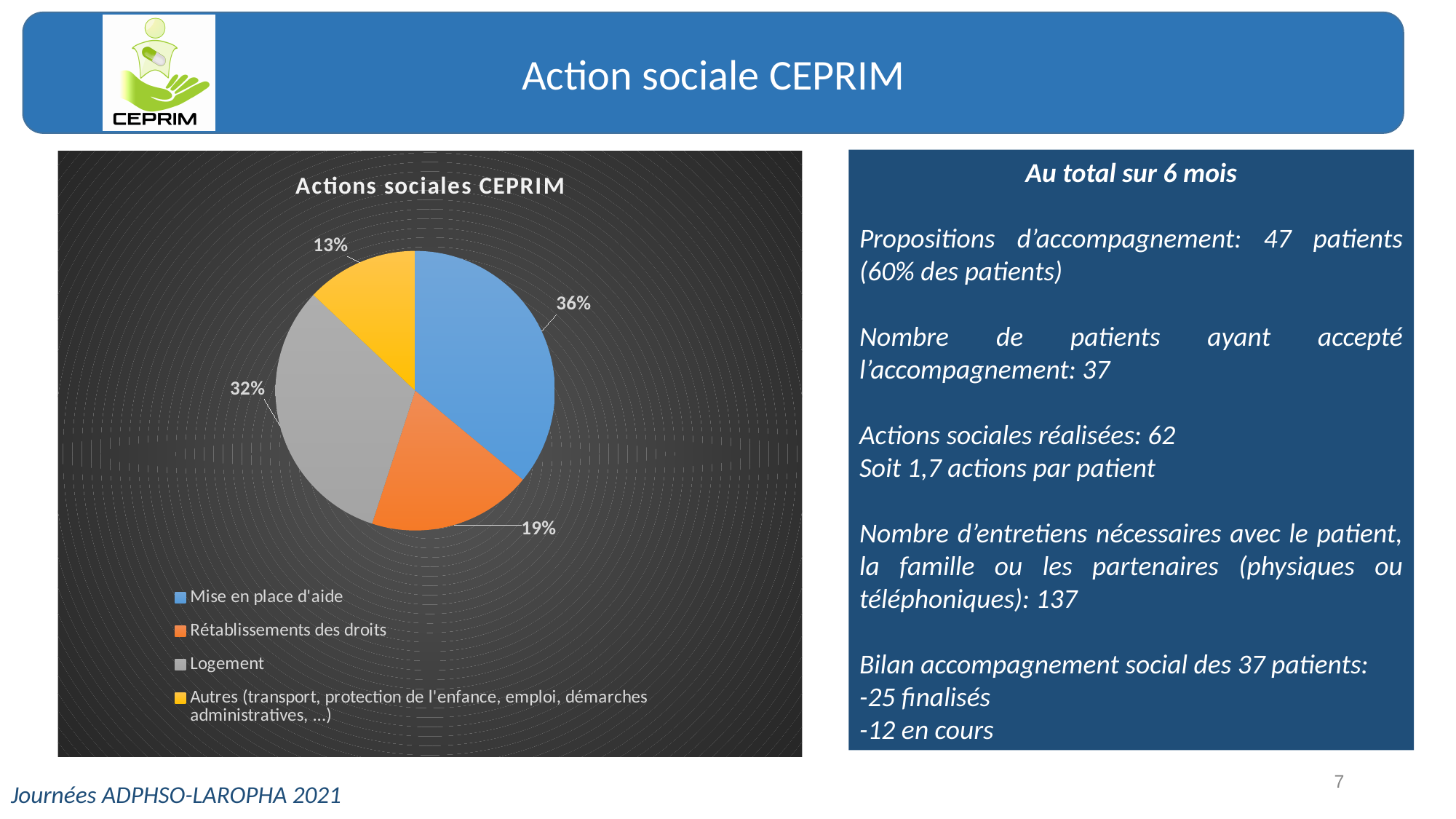
Which colour represents "Logement" in the pie chart? gray What type of chart is shown on the slide? pie chart Which category has the smallest share of the pie? Autres (transport, protection de l'enfance, emploi, démarches administratives, ...) Which category has the largest share of the pie? Mise en place d'aide What share of the pie does the "Autres" category represent? 13% What share of the pie does "Mise en place d'aide" represent? 36% What is the title of the chart? Actions sociales CEPRIM How many slices does the pie chart have? 4 What share of the pie does "Rétablissements des droits" represent? 19% What is the difference in percentage points between "Mise en place d'aide" and "Logement"? 4 Which is larger: the share for "Rétablissements des droits" or the share for "Logement"? Logement